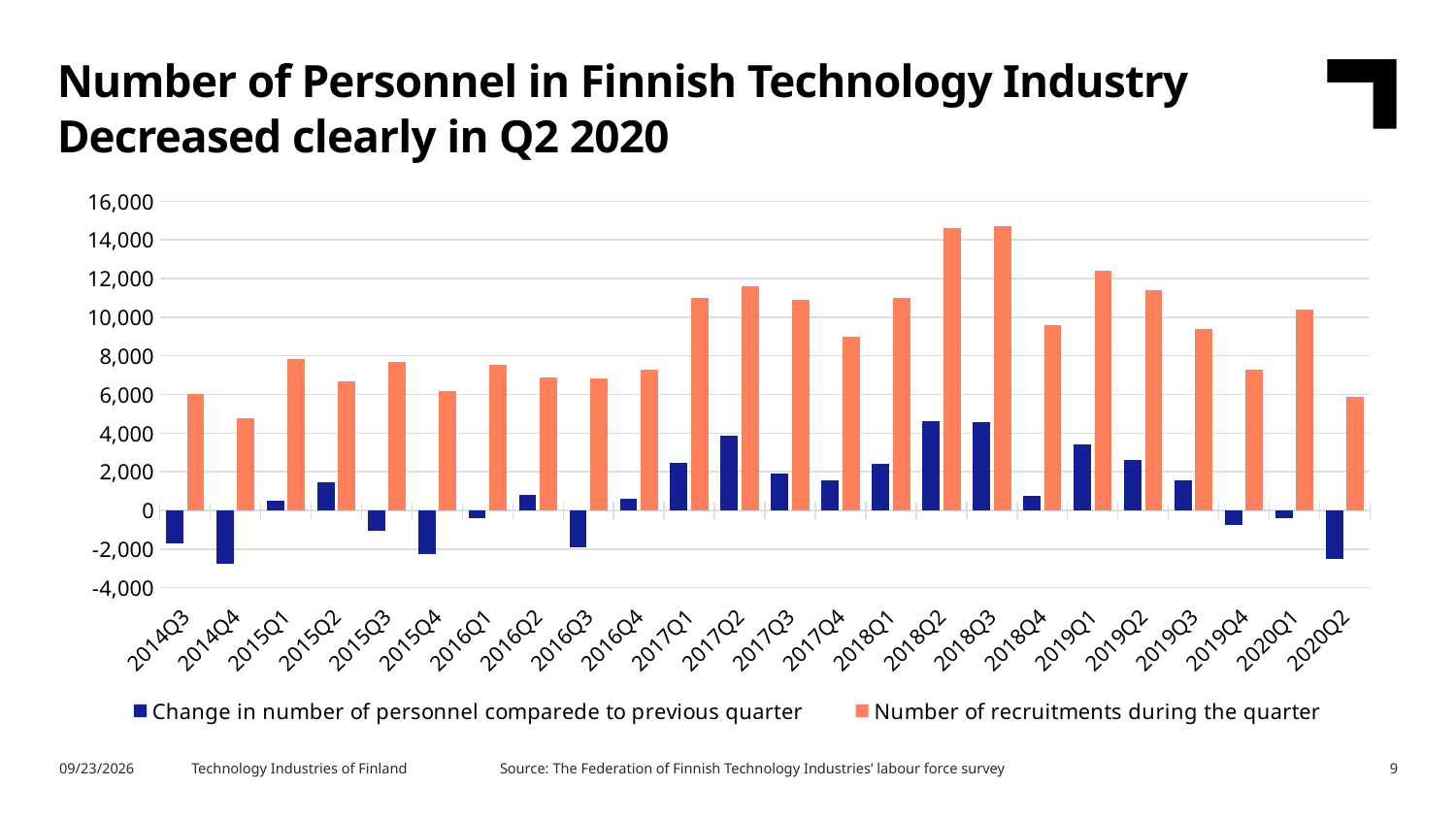
Which quarter has the lowest number of recruitments during the quarter? 2014Q4 Is the number of recruitments during the quarter for 2020Q2 greater or less than 8,000? less What kind of chart is shown on the slide? Bar chart Is the change in number of personnel compared to previous quarter for 2020Q2 greater or less than -2,000? less How many quarters are shown on the x axis? 24 Is the number of recruitments during the quarter for 2018Q2 greater or less than 14,000? greater How many series does the legend list? 2 Which quarter has a larger change in number of personnel compared to previous quarter, 2018Q2 or 2018Q4? 2018Q2 Which quarter has more recruitments during the quarter, 2016Q4 or 2017Q1? 2017Q1 Do the number of recruitments during the quarter rise or fall from 2019Q1 to 2019Q4? fall What colour are the bars for the number of recruitments during the quarter? Orange